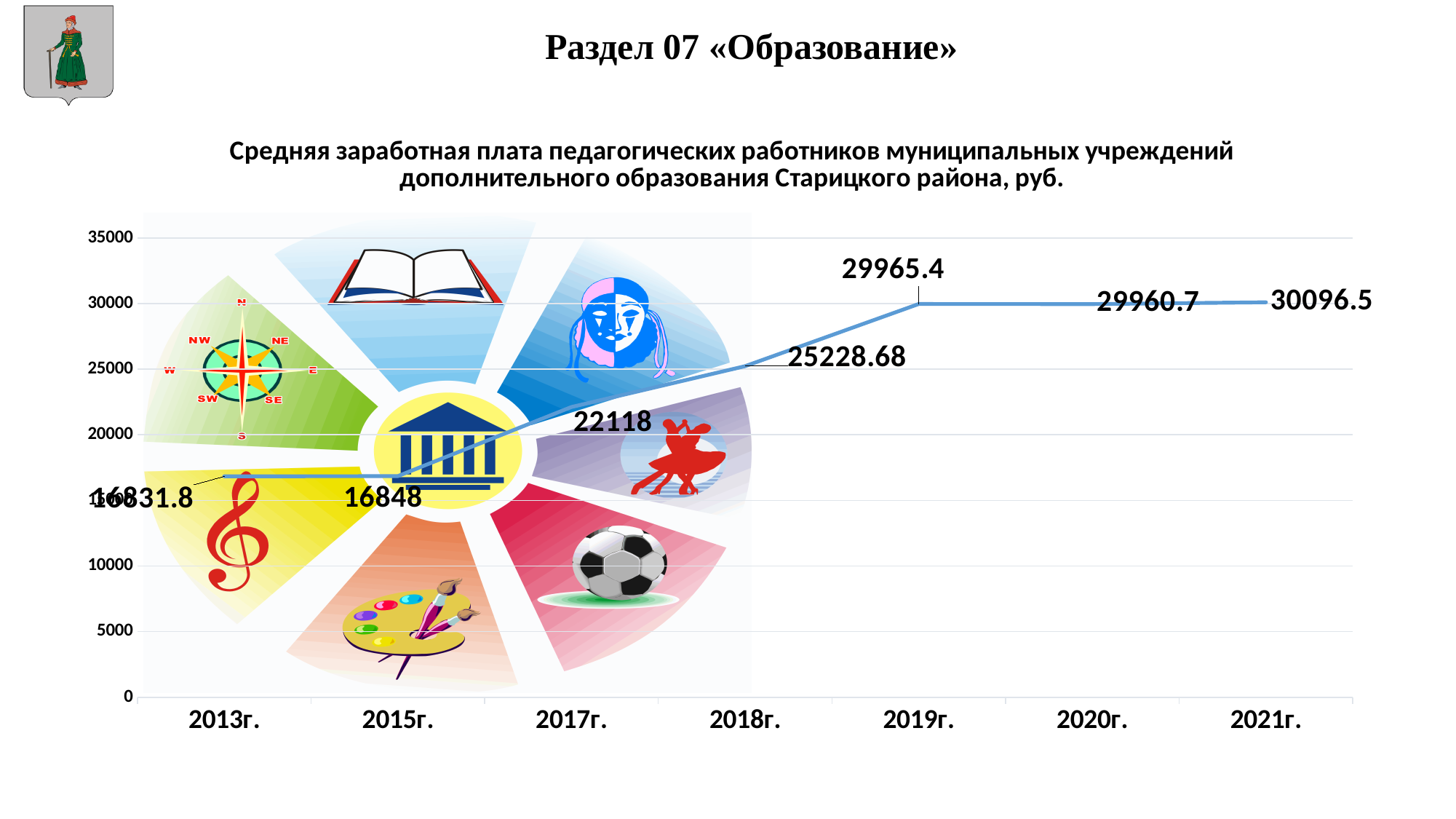
Which is larger, the value for 2019г. or the value for 2020г.? 2019г. Is the value for 2013г. greater or less than 15000? greater What is the difference between the values for 2019г. and 2018г.? 4736.72 How many years are plotted on the chart? 7 What is the value for 2018г.? 25228.68 What is the value for 2015г.? 16848 What is the value for 2019г.? 29965.4 Which year has the highest value? 2021г. What is the value for 2021г.? 30096.5 What is the value for 2017г.? 22118 What is the difference between the values for 2021г. and 2020г.? 135.8 What kind of chart is shown on the slide? line chart